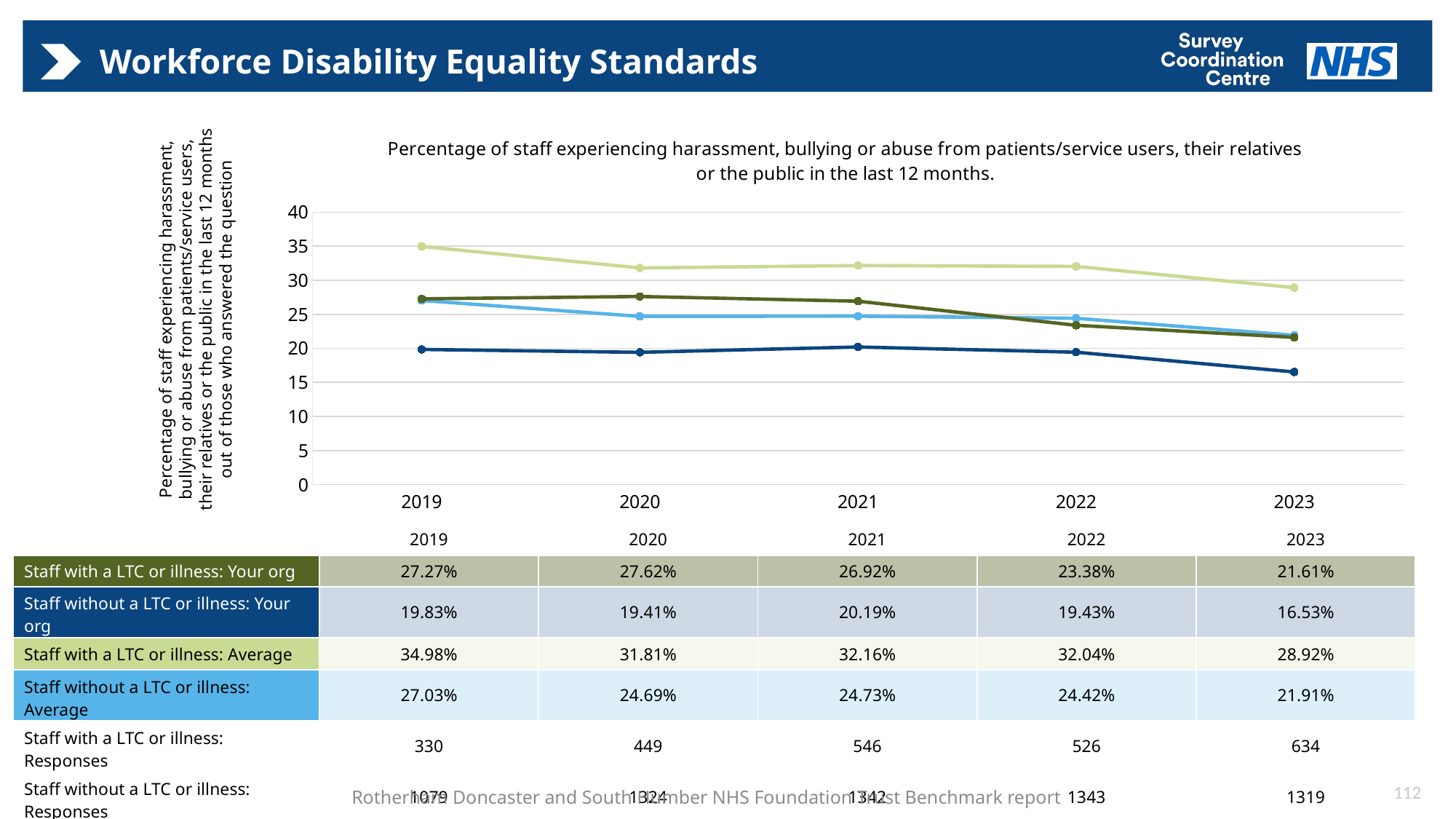
What is the value for Staff without a LTC or illness: Average in 2020? 24.69% How many years are shown on the x axis? 5 Does the value for Staff with a LTC or illness: Your org rise or fall from 2021 to 2023? fall What is the difference between Staff with a LTC or illness: Your org and Staff without a LTC or illness: Your org in 2022? 3.95% What is the value for Staff with a LTC or illness: Your org in 2019? 27.27% What kind of chart is shown on the slide? line chart What is the value for Staff with a LTC or illness: Average in 2021? 32.16% What is the value for Staff without a LTC or illness: Your org in 2023? 16.53% Which is larger in 2023: Staff with a LTC or illness: Your org or Staff without a LTC or illness: Average? Staff without a LTC or illness: Average In which year is the value for Staff with a LTC or illness: Average highest? 2019 Is the value for Staff with a LTC or illness: Average in 2019 greater or less than 30? greater In which year is the value for Staff without a LTC or illness: Your org lowest? 2023